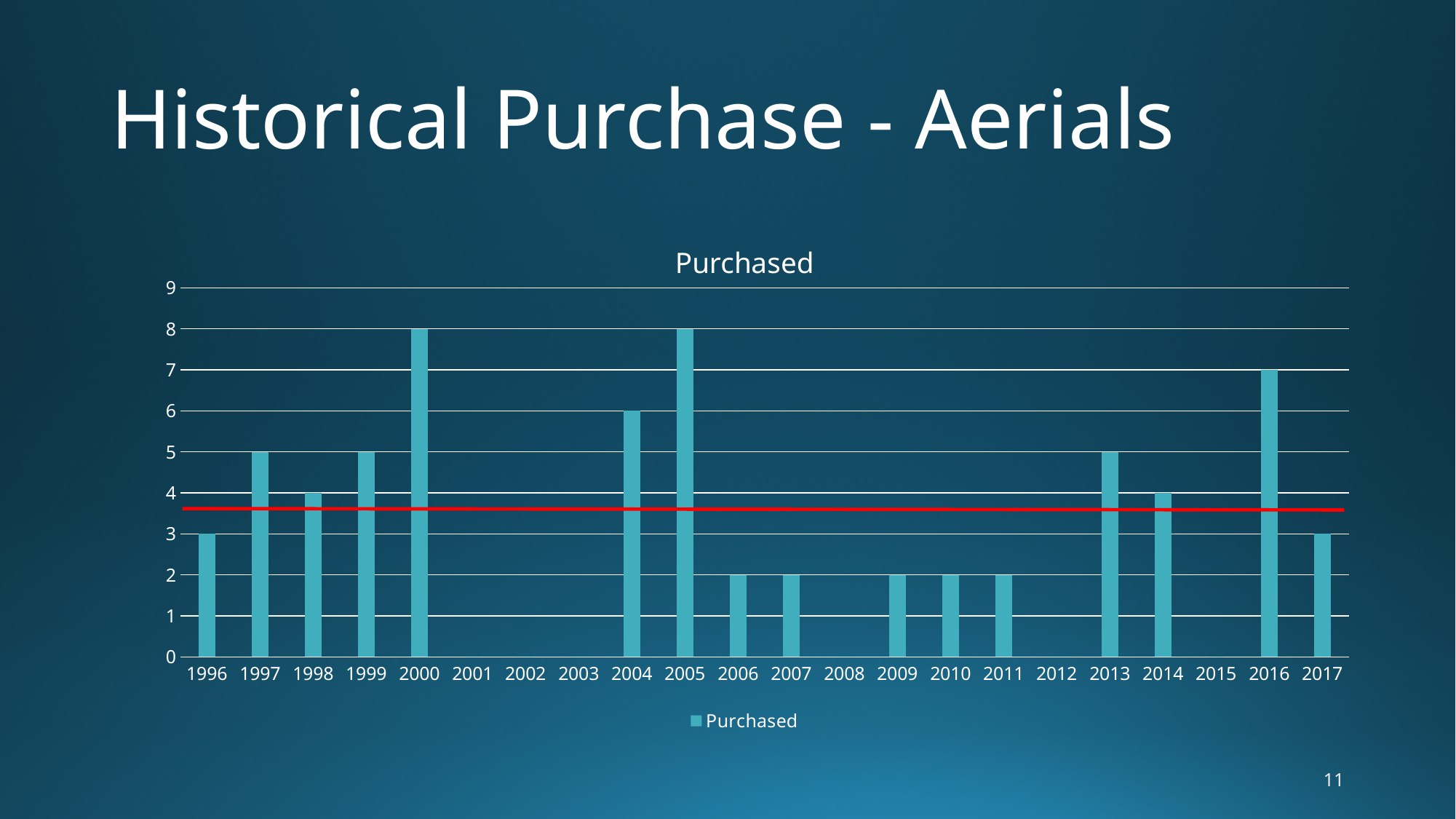
What is the value for 2016 in the Purchased chart? 7 Which is larger, the value for 2004 or the value for 2013? 2004 What is the difference between the values for 2000 and 2017? 5 What is the value for 2004 in the Purchased chart? 6 What is the title of the chart? Purchased How many series does the legend list? 1 How many years are shown on the x axis of the chart? 22 Which years have the highest value in the Purchased chart? 2000 and 2005 What kind of chart is shown on the slide? bar chart What is the value for 2017 in the Purchased chart? 3 Is the value for 2016 greater or less than 5? greater What is the value for 2000 in the Purchased chart? 8